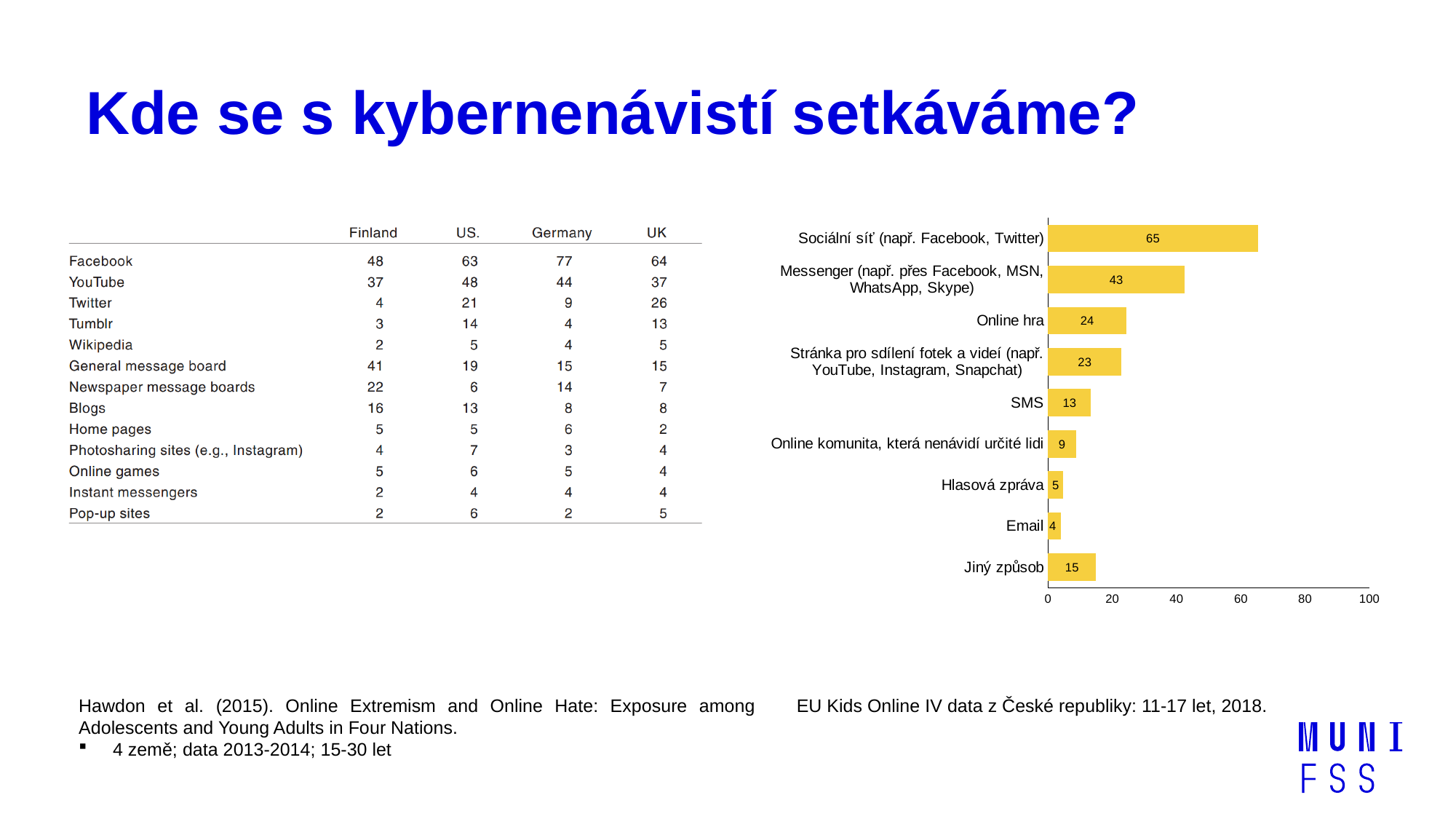
What kind of chart is shown on the right of the slide? bar chart How many categories are shown in the bar chart on the right? 9 What is the highest value shown on the horizontal axis of the bar chart on the right? 100 In the bar chart on the right, what is the value for Sociální síť (např. Facebook, Twitter)? 65 In the bar chart on the right, which category has the lowest value? Email In the bar chart on the right, which category has the highest value? Sociální síť (např. Facebook, Twitter) In the bar chart on the right, what is the value for SMS? 13 In the bar chart on the right, what is the value for Messenger (např. přes Facebook, MSN, WhatsApp, Skype)? 43 In the bar chart on the right, what is the difference between the values for Sociální síť and Messenger? 22 In the bar chart on the right, is the value for Sociální síť greater or less than 60? greater In the bar chart on the right, what is the value for Jiný způsob? 15 In the bar chart on the right, which is larger: the value for Messenger or the value for Online hra? Messenger